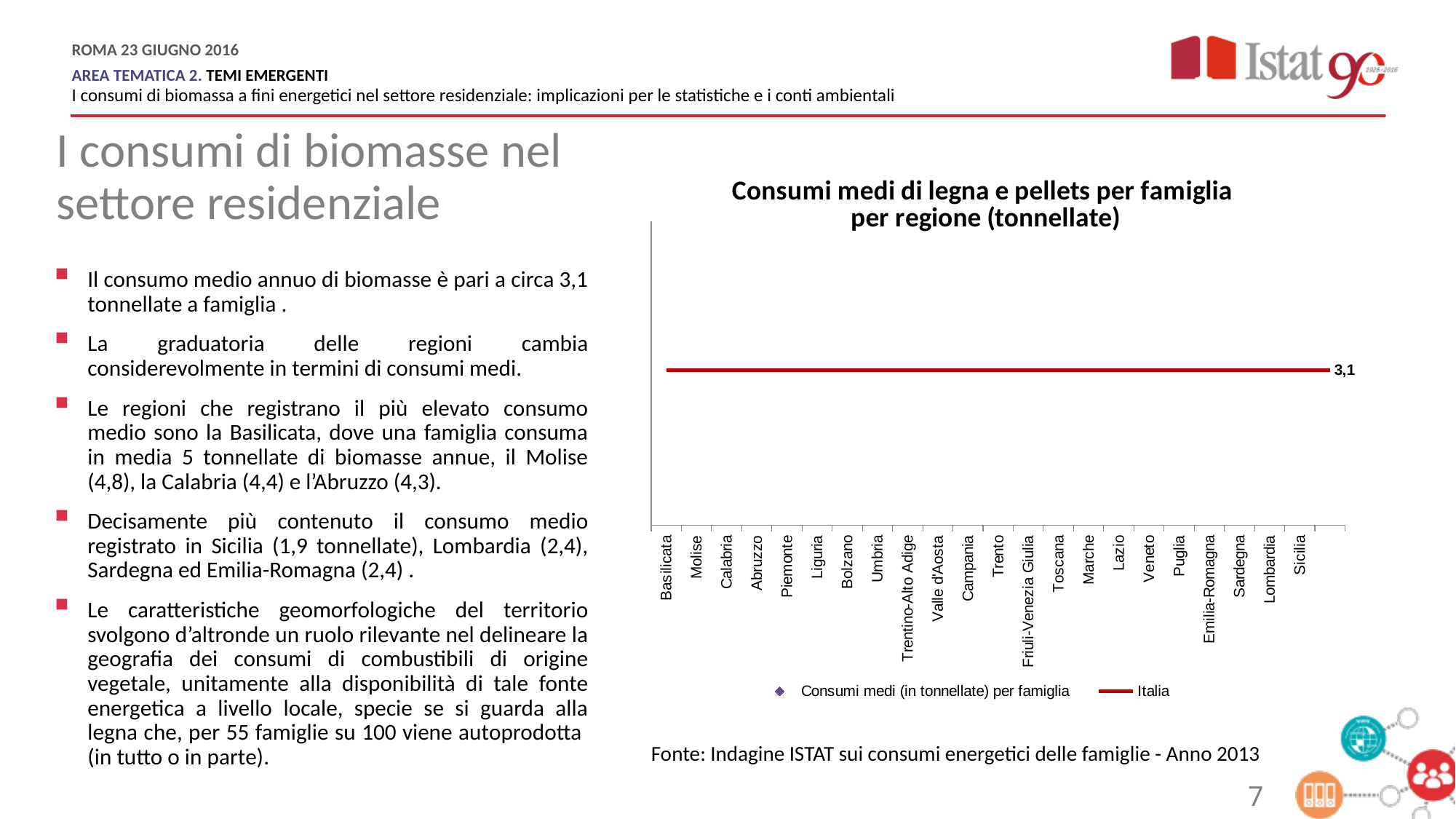
How many series does the chart legend list? 2 What is the name of the series drawn as a red line in the chart? Italia How many regions are listed along the x axis of the chart? 22 What value is labelled on the horizontal 'Italia' line in the chart? 3,1 Which region is listed first on the x axis of the chart? Basilicata What unit is stated in the chart title for the consumption values? tonnellate What is the title of the chart? Consumi medi di legna e pellets per famiglia per regione (tonnellate) Which region is listed last on the x axis of the chart? Sicilia